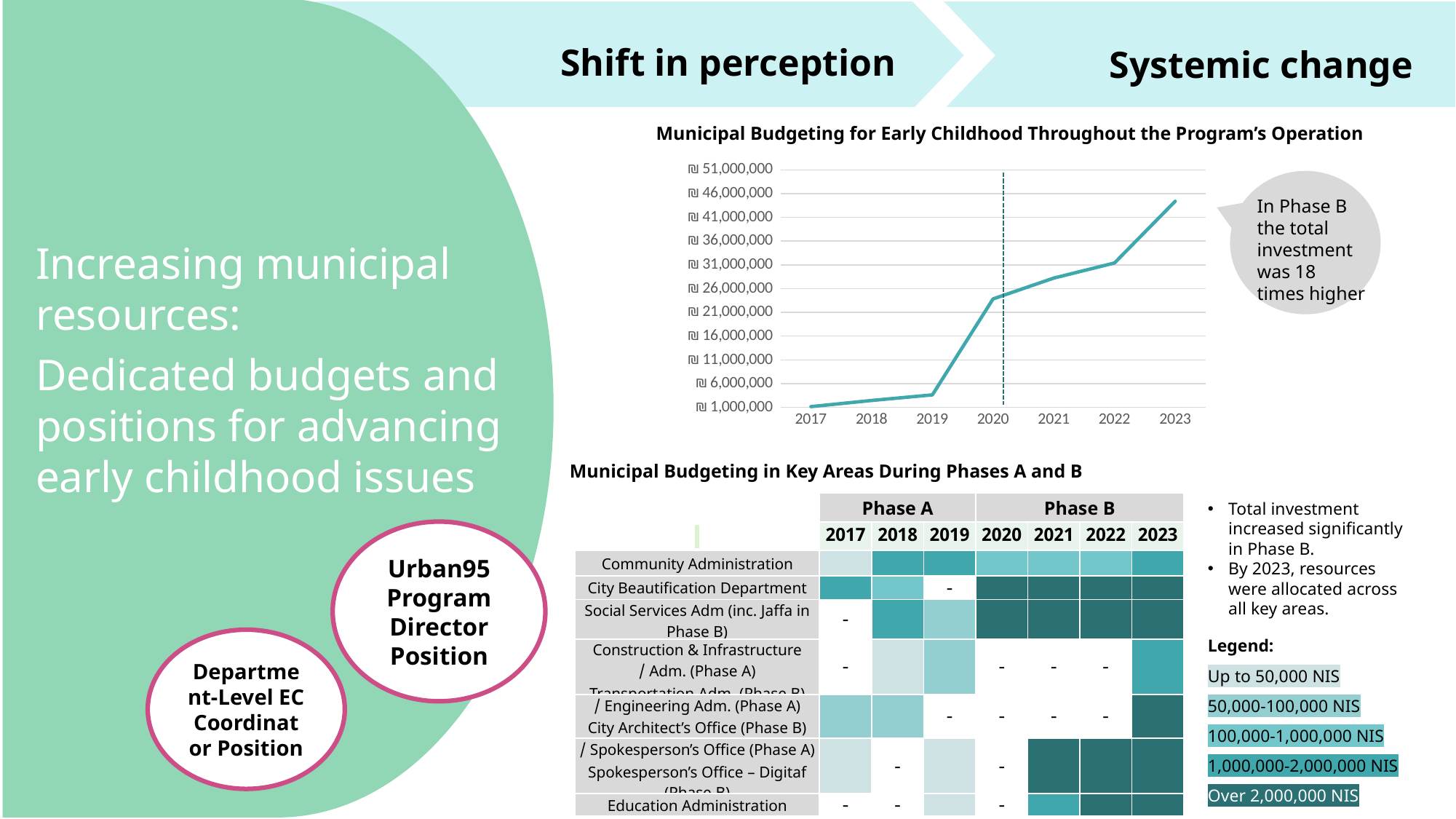
What kind of chart is 'Municipal Budgeting for Early Childhood Throughout the Program's Operation'? line chart In the line chart, is the value for 2022 greater or less than ₪ 26,000,000? greater In the line chart, is the value for 2019 greater or less than ₪ 6,000,000? less What is the title of the line chart on the slide? Municipal Budgeting for Early Childhood Throughout the Program's Operation In the line chart, is the value for 2021 greater or less than ₪ 31,000,000? less In the line chart, how many years are shown on the x axis? 7 In the line chart, which year has the lowest municipal budget? 2017 In the line chart, which year has the highest municipal budget? 2023 In the line chart, do the values rise or fall from 2017 to 2023? rise In the line chart, which year has the larger budget, 2019 or 2020? 2020